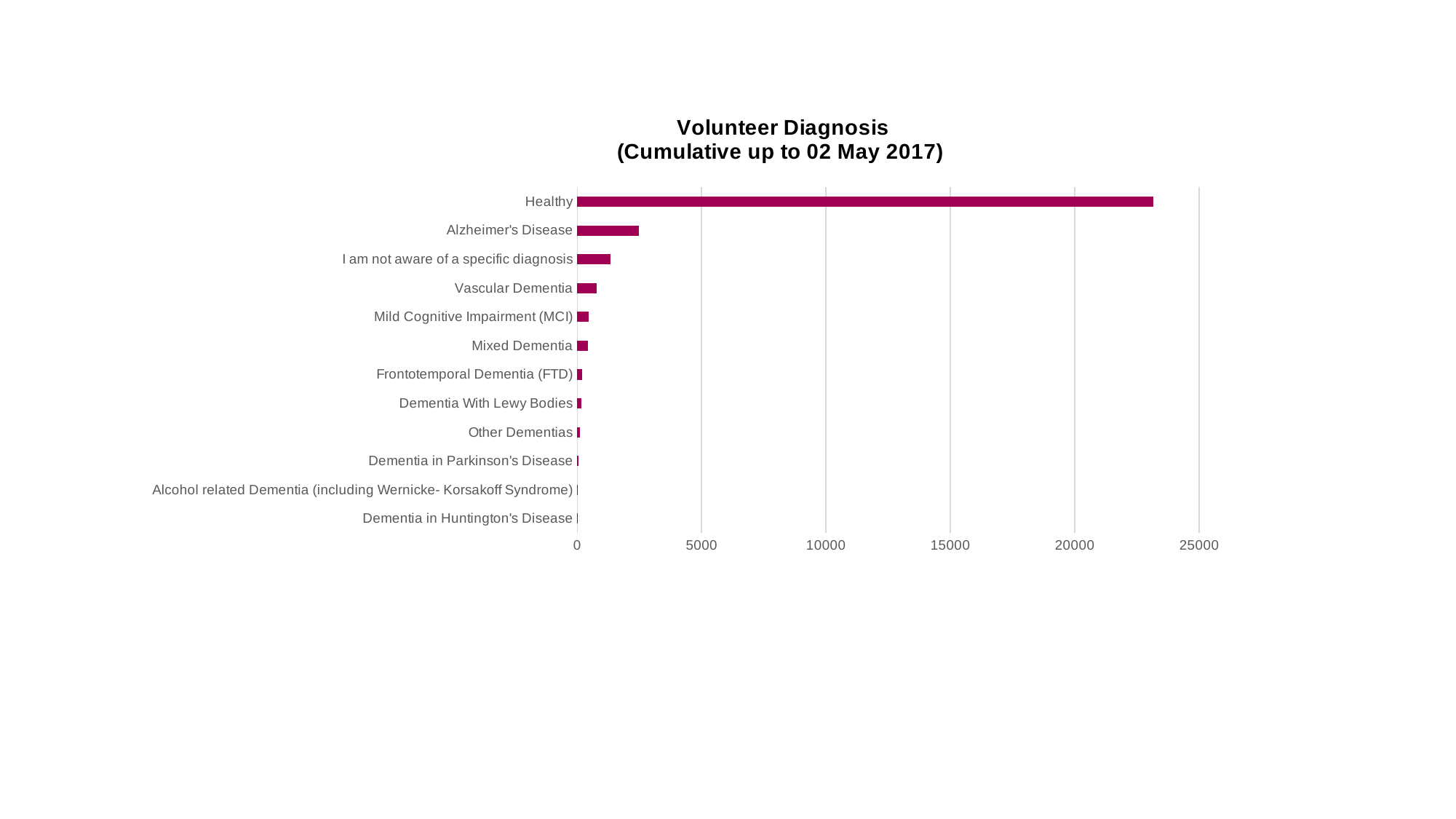
Which category has the highest value? Healthy What is the title of the chart? Volunteer Diagnosis (Cumulative up to 02 May 2017) Is the value for Alzheimer's Disease greater or less than 5000? less Which is larger, the value for Alzheimer's Disease or the value for Vascular Dementia? Alzheimer's Disease Is the value for Healthy greater or less than 20000? greater Which is larger, the value for 'I am not aware of a specific diagnosis' or the value for Vascular Dementia? I am not aware of a specific diagnosis Which is larger, the value for Healthy or the value for Alzheimer's Disease? Healthy Is the value for Vascular Dementia greater or less than 5000? less What is the highest value shown on the horizontal axis? 25000 How many diagnosis categories are plotted in the chart? 12 What kind of chart is shown on the slide? Bar chart